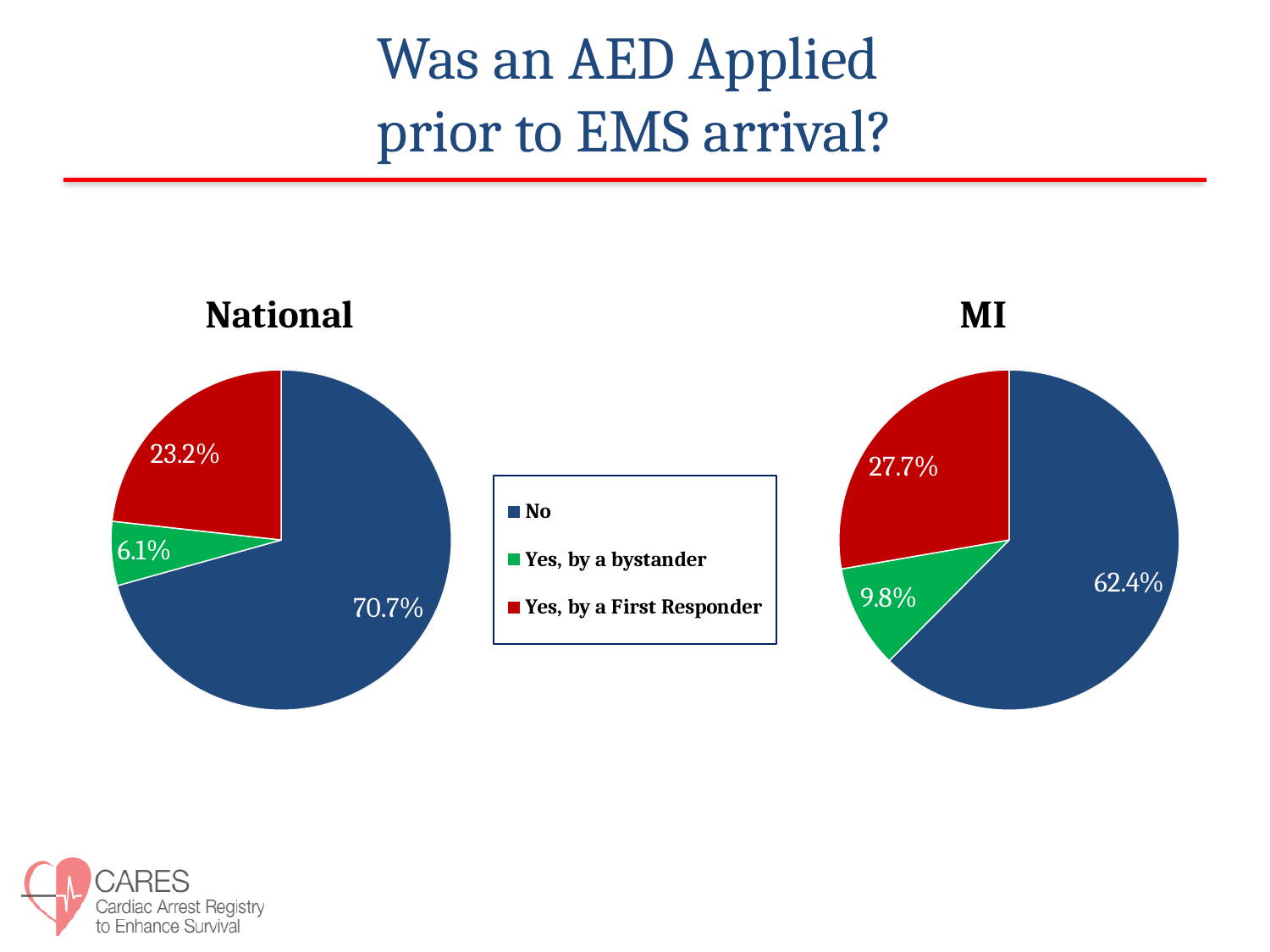
What type of chart is used on this slide? Pie chart In the MI pie chart, which category has the smallest slice? Yes, by a bystander What is the difference between the "No" percentage in the National chart and the "No" percentage in the MI chart? 8.3% In the MI pie chart, what percentage is shown for "Yes, by a bystander"? 9.8% What is the title of the slide? Was an AED Applied prior to EMS arrival? In the National pie chart, which category has the largest slice? No What colour represents "Yes, by a bystander" in the legend? Green How many categories does each pie chart have? 3 In the National pie chart, what percentage is shown for "No"? 70.7% Which chart shows a larger percentage for "Yes, by a First Responder", National or MI? MI In the National pie chart, what percentage is shown for "Yes, by a bystander"? 6.1% In the MI pie chart, what percentage is shown for "Yes, by a First Responder"? 27.7%